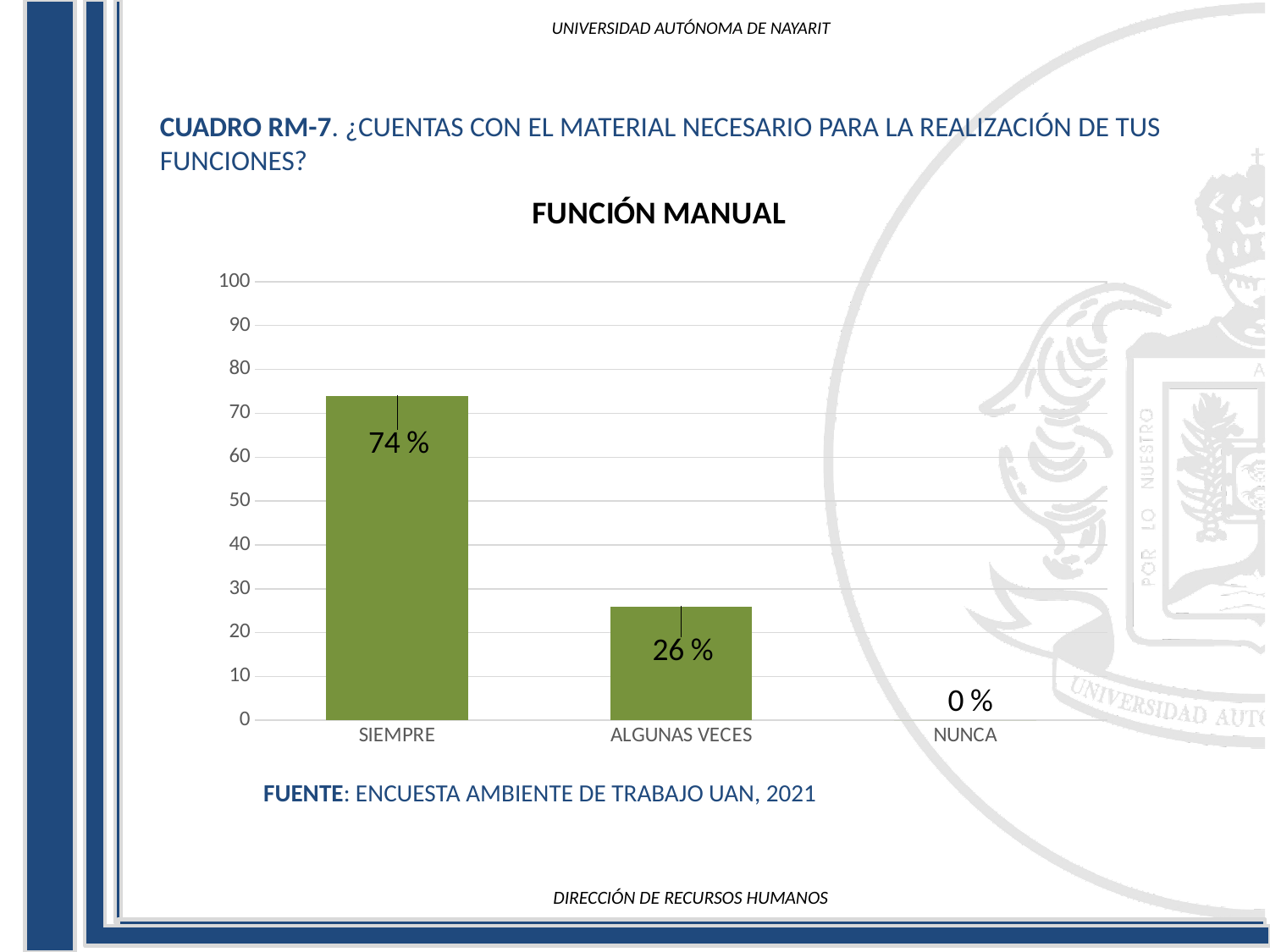
What is the value for ALGUNAS VECES? 26 % Which category has the highest value? SIEMPRE What is the difference between the values for SIEMPRE and ALGUNAS VECES? 48 % What is the value for NUNCA? 0 % How many categories are shown on the x axis? 3 Is the value for ALGUNAS VECES greater or less than 30? less Which is larger, the value for SIEMPRE or the value for ALGUNAS VECES? SIEMPRE What is the value for SIEMPRE? 74 % Is the value for SIEMPRE greater or less than 70? greater Which category has the lowest value? NUNCA What kind of chart is shown on the slide? Bar chart What is the title of the chart? FUNCIÓN MANUAL